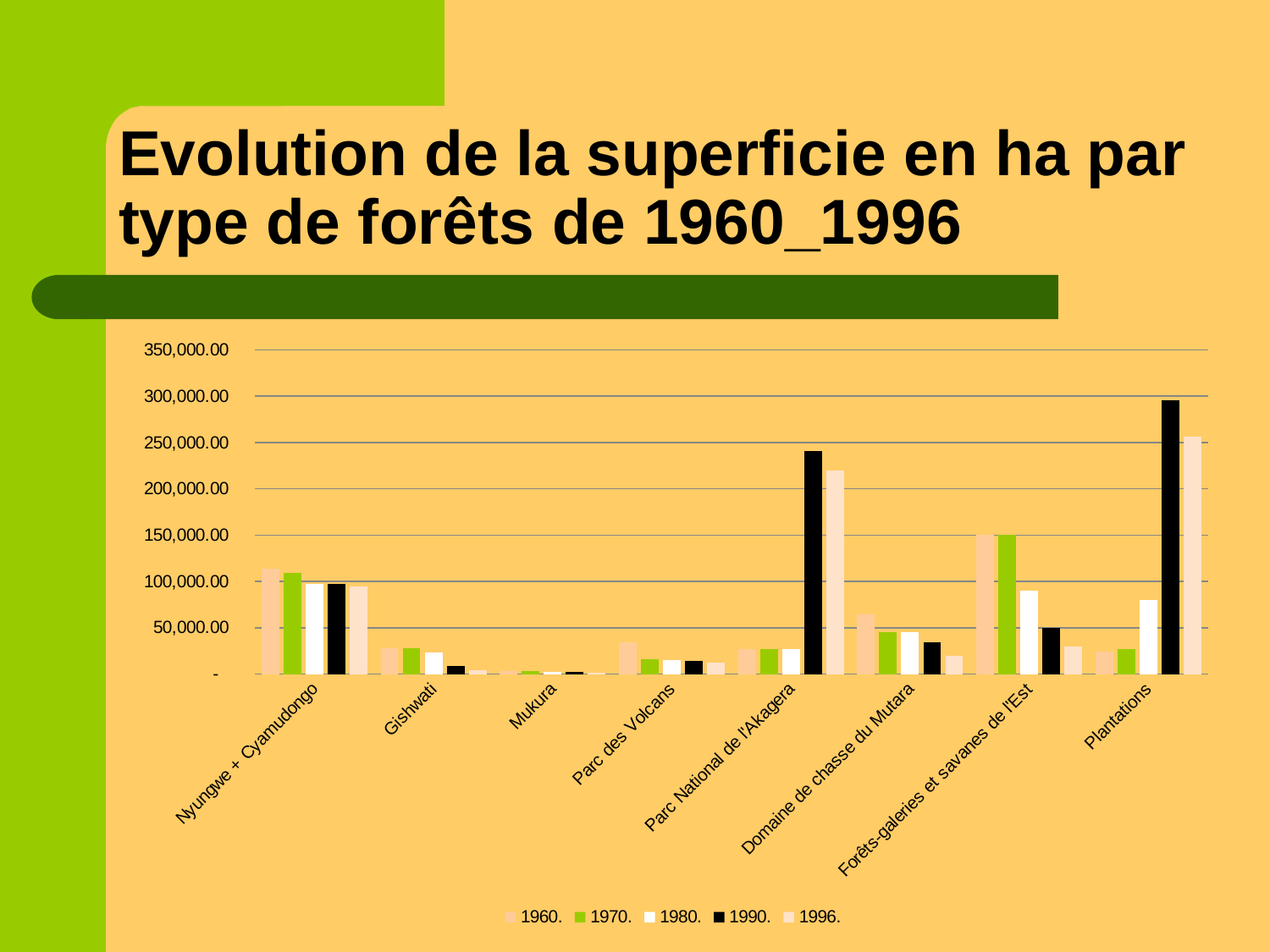
How many forest-type categories are shown on the x axis? 8 Which category has the lowest values across all years? Mukura Which is larger for the 1990 series: Plantations or Parc National de l'Akagera? Plantations Is the 1960 value for Nyungwe + Cyamudongo greater or less than 100,000? greater Is the 1996 value for Parc National de l'Akagera greater or less than 200,000? greater Is the 1990 value for Plantations greater or less than 250,000? greater Which year is represented by the black bars in the legend? 1990 How many series does the legend list? 5 Which category has the highest value for the 1990 series? Plantations What kind of chart is shown on the slide? Bar chart Do the values for Gishwati rise or fall from 1960 to 1996? fall Do the values for Forêts-galeries et savanes de l'Est rise or fall from 1960 to 1996? fall